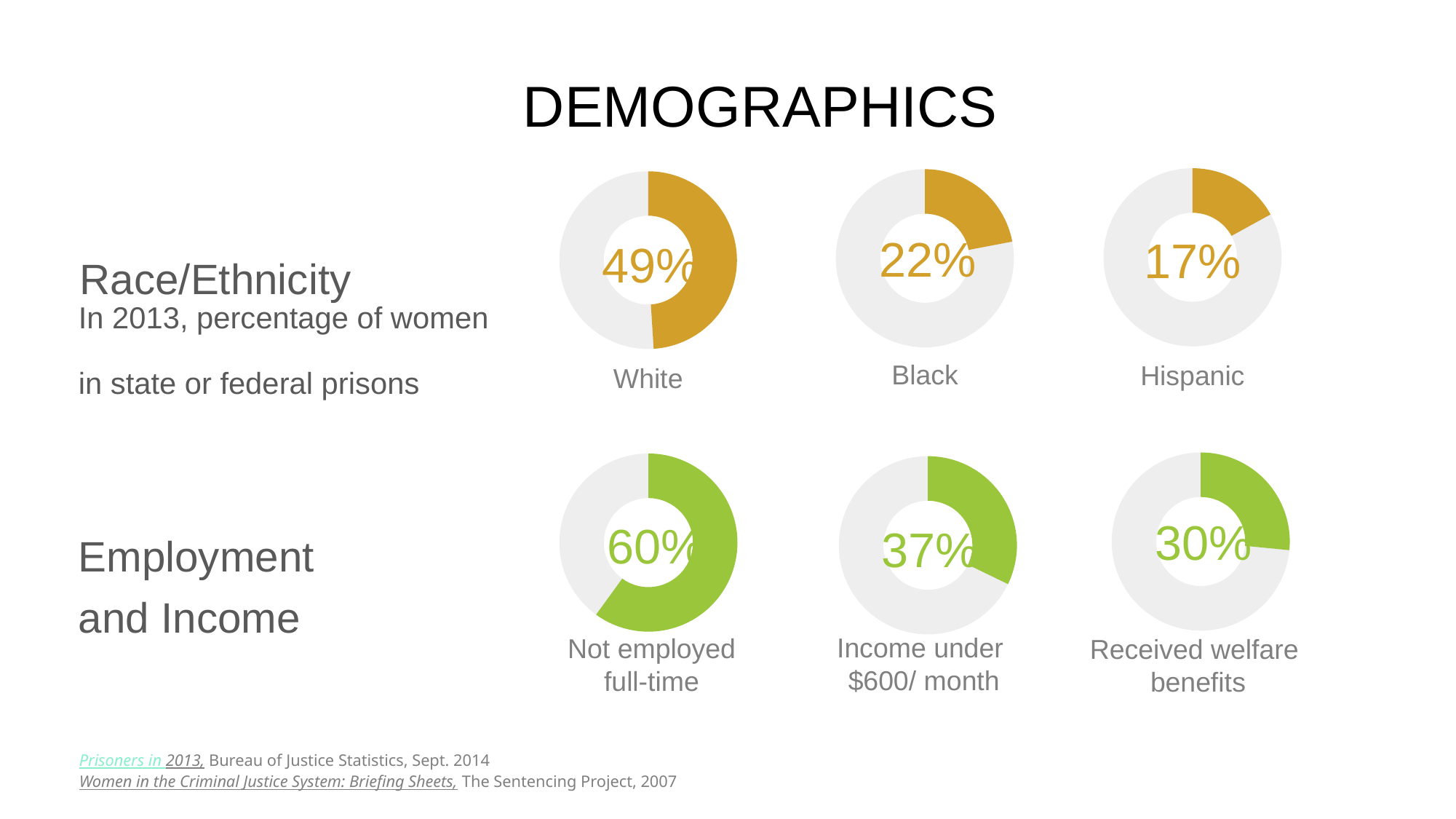
In the Race/Ethnicity row, what percentage is shown in the Black donut chart? 22% What kind of chart is used to display each percentage on the slide? Donut chart In the Employment and Income row, which is larger: 'Income under $600/ month' or 'Received welfare benefits'? Income under $600/ month In the Race/Ethnicity row, what is the difference between the White and Black percentages? 27% In the Employment and Income row, what percentage is shown for 'Income under $600/ month'? 37% In the Employment and Income row, what percentage is shown for 'Not employed full-time'? 60% Among the three Race/Ethnicity donut charts, which category has the lowest percentage? Hispanic Among the three Race/Ethnicity donut charts, which category has the highest percentage? White In the Race/Ethnicity row, what percentage is shown in the White donut chart? 49% In the Race/Ethnicity row, what percentage is shown in the Hispanic donut chart? 17% In the Employment and Income row, what percentage is shown for 'Received welfare benefits'? 30% In the Employment and Income row, what is the difference between 'Not employed full-time' and 'Received welfare benefits'? 30%